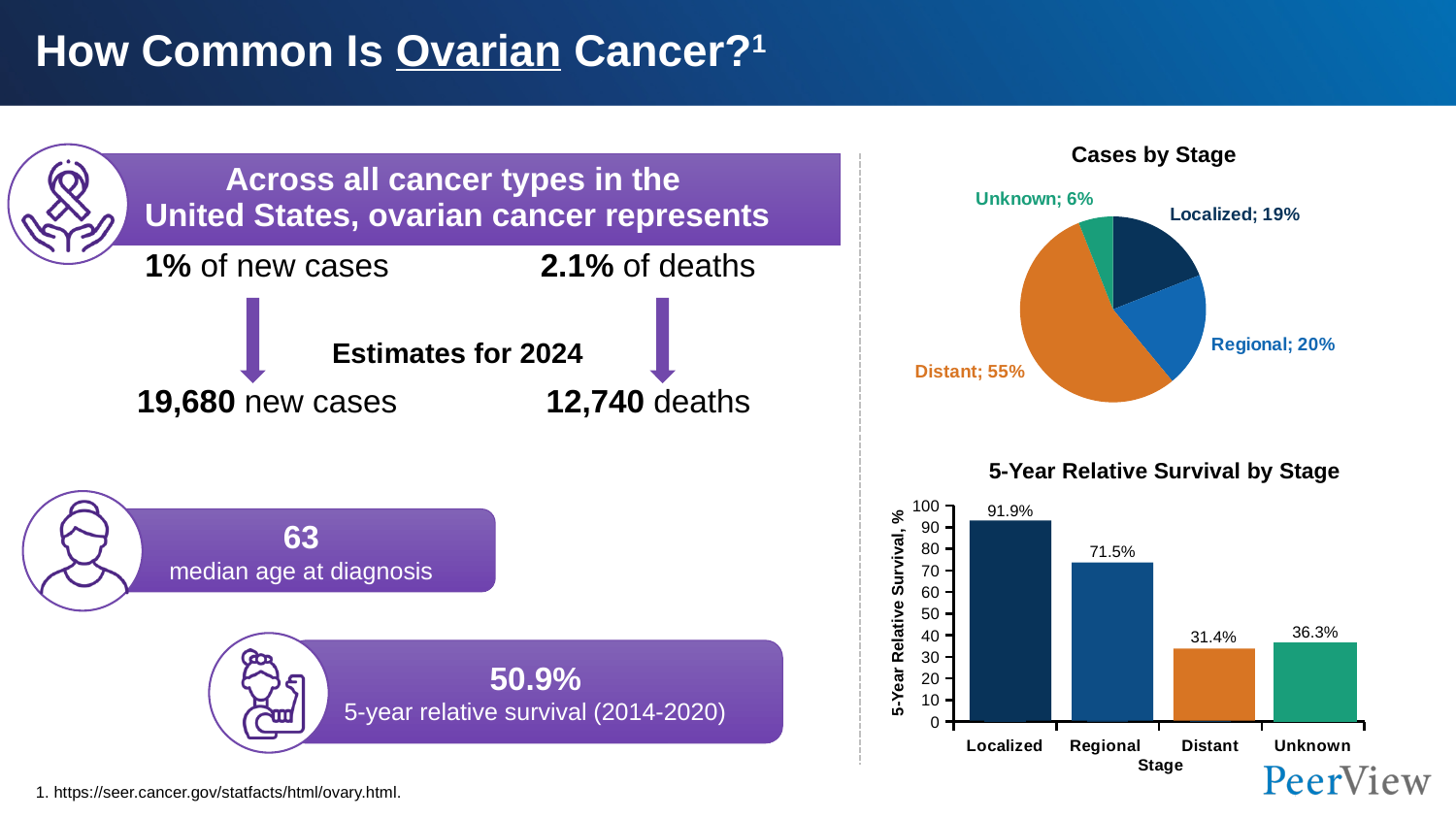
In the '5-Year Relative Survival by Stage' chart, what is the value for Regional? 71.5% In the '5-Year Relative Survival by Stage' chart, which stage has the lowest survival? Distant In the 'Cases by Stage' pie chart, what is the difference between the Regional and Localized shares? 1% In the 'Cases by Stage' pie chart, which stage has the smallest share? Unknown In the '5-Year Relative Survival by Stage' chart, what is the difference between Localized and Distant? 60.5% In the '5-Year Relative Survival by Stage' chart, which is larger, Unknown or Distant? Unknown In the '5-Year Relative Survival by Stage' chart, which stage has the highest survival? Localized What kind of chart is '5-Year Relative Survival by Stage'? Bar chart In the 'Cases by Stage' pie chart, how many slices are there? 4 In the '5-Year Relative Survival by Stage' chart, what is the y-axis label? 5-Year Relative Survival, % In the 'Cases by Stage' pie chart, which stage has the largest share? Distant In the 'Cases by Stage' pie chart, what share of cases is Distant? 55%